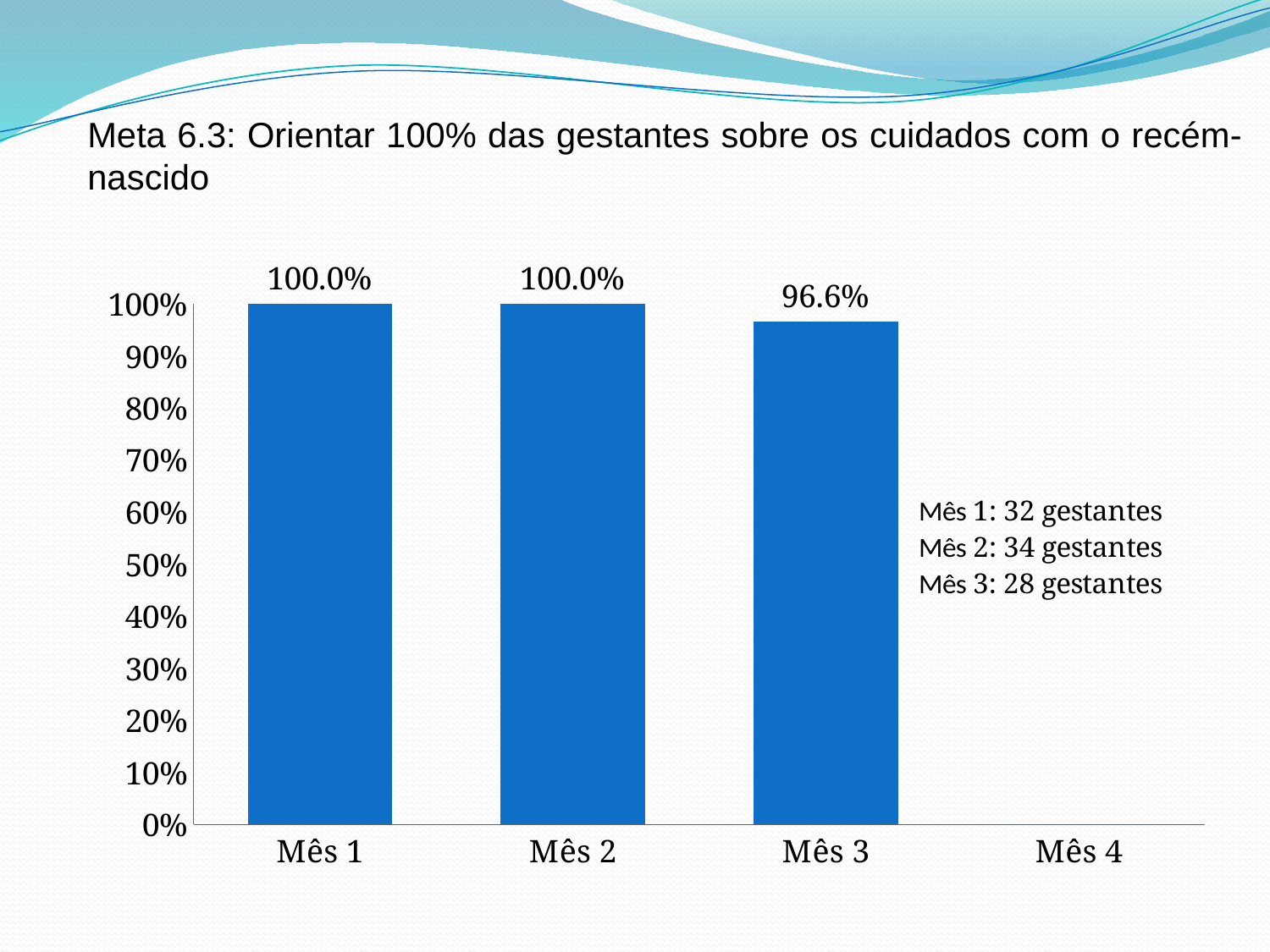
What kind of chart is shown on the slide? bar chart What is the value for Mês 2? 100.0% What is the value for Mês 3? 96.6% Which month has the lowest value among the plotted bars? Mês 3 What is the difference between the values for Mês 1 and Mês 3? 3.4% Do the values rise or fall from Mês 2 to Mês 3? fall What is the value for Mês 1? 100.0% Which is larger, the value for Mês 2 or the value for Mês 3? Mês 2 How many month categories are shown on the x axis? 4 According to the text next to the chart, how many gestantes were there in Mês 2? 34 gestantes How many months have a bar plotted? 3 Is the value for Mês 3 greater or less than 90%? greater